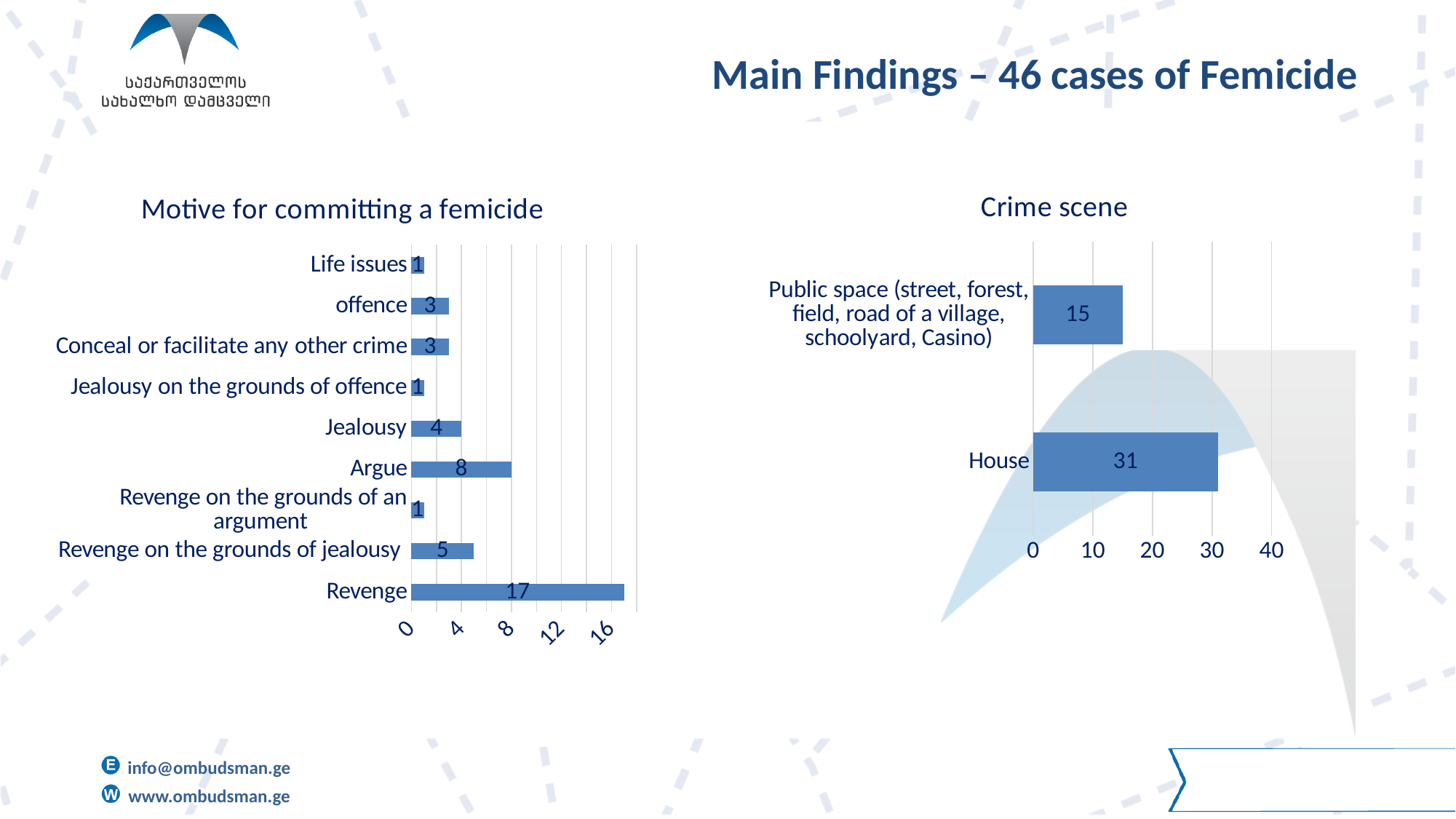
What kind of chart is the 'Crime scene' chart? Bar chart How many motive categories are shown in the 'Motive for committing a femicide' chart? 9 In the 'Motive for committing a femicide' chart, what is the value for Argue? 8 In the 'Motive for committing a femicide' chart, which motive has the highest value? Revenge In the 'Crime scene' chart, what is the value for Public space (street, forest, field, road of a village, schoolyard, Casino)? 15 In the 'Crime scene' chart, what is the difference between House and Public space? 16 In the 'Motive for committing a femicide' chart, what is the value for Revenge on the grounds of jealousy? 5 In the 'Motive for committing a femicide' chart, what is the difference between Revenge and Argue? 9 In the 'Motive for committing a femicide' chart, what is the value for Revenge? 17 In the 'Crime scene' chart, is the value for House greater or less than 20? greater In the 'Motive for committing a femicide' chart, which is larger: Jealousy or offence? Jealousy In the 'Crime scene' chart, what is the value for House? 31